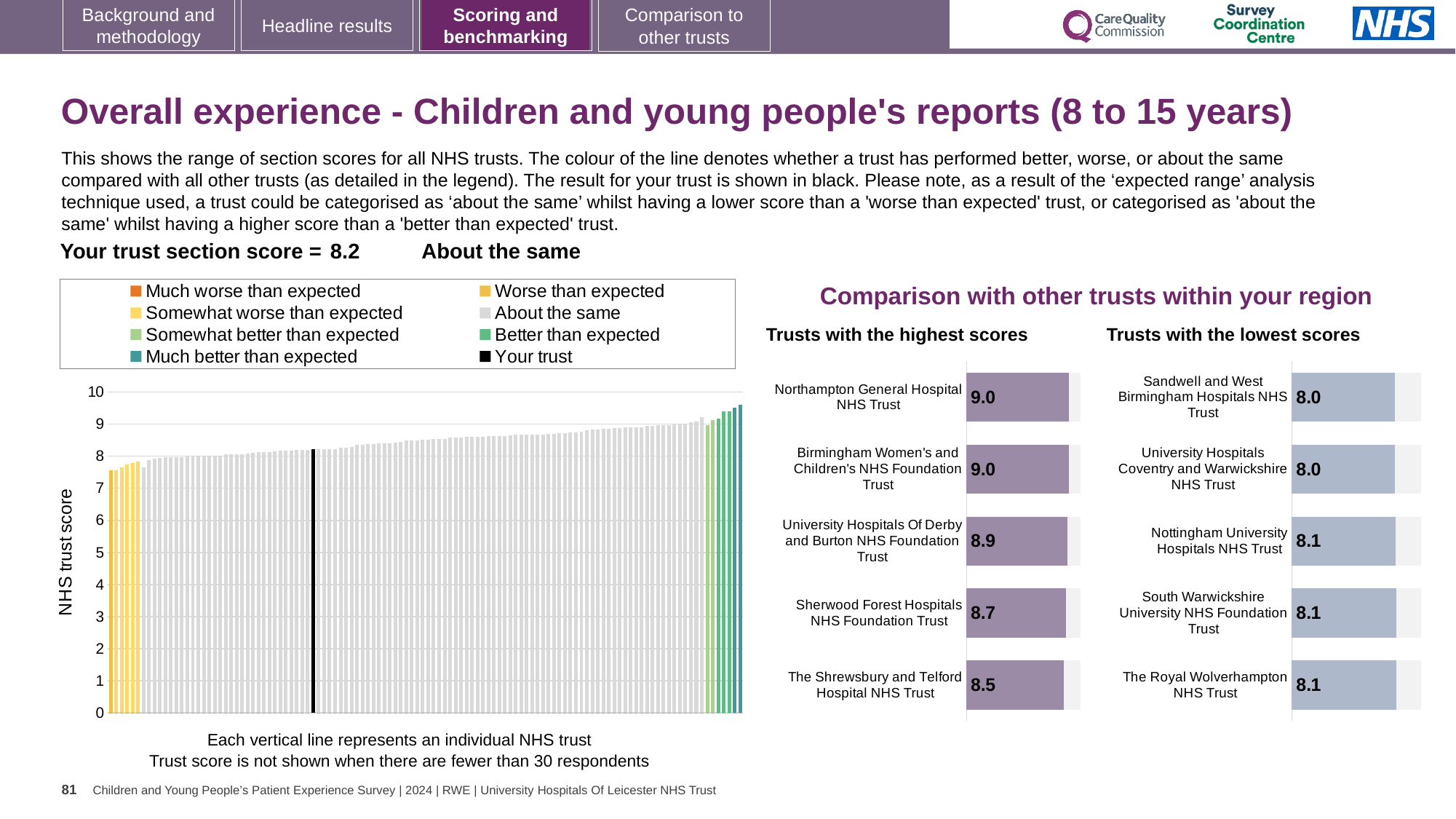
In the large chart on the left showing all NHS trusts, do the bar values rise or fall from left to right? rise What is the y-axis label of the large chart on the left? NHS trust score How many trusts are shown in the 'Trusts with the lowest scores' chart? 5 In the 'Trusts with the highest scores' chart, what is the score for Sherwood Forest Hospitals NHS Foundation Trust? 8.7 In the 'Trusts with the lowest scores' chart, what is the score for Nottingham University Hospitals NHS Trust? 8.1 In the 'Trusts with the lowest scores' chart, what is the score for University Hospitals Coventry and Warwickshire NHS Trust? 8.0 In the 'Trusts with the highest scores' chart, what is the difference between the scores of Northampton General Hospital NHS Trust and The Shrewsbury and Telford Hospital NHS Trust? 0.5 In the large chart on the left showing all NHS trusts, is the value of the leftmost bar greater or less than 8? less In the 'Trusts with the highest scores' chart, which has the larger score: University Hospitals Of Derby and Burton NHS Foundation Trust or Sherwood Forest Hospitals NHS Foundation Trust? University Hospitals Of Derby and Burton NHS Foundation Trust In the 'Trusts with the highest scores' chart, which trust has the lowest score? The Shrewsbury and Telford Hospital NHS Trust How many entries does the legend of the large chart on the left list? 8 In the large chart on the left showing all NHS trusts, is the value of the rightmost bar greater or less than 9? greater